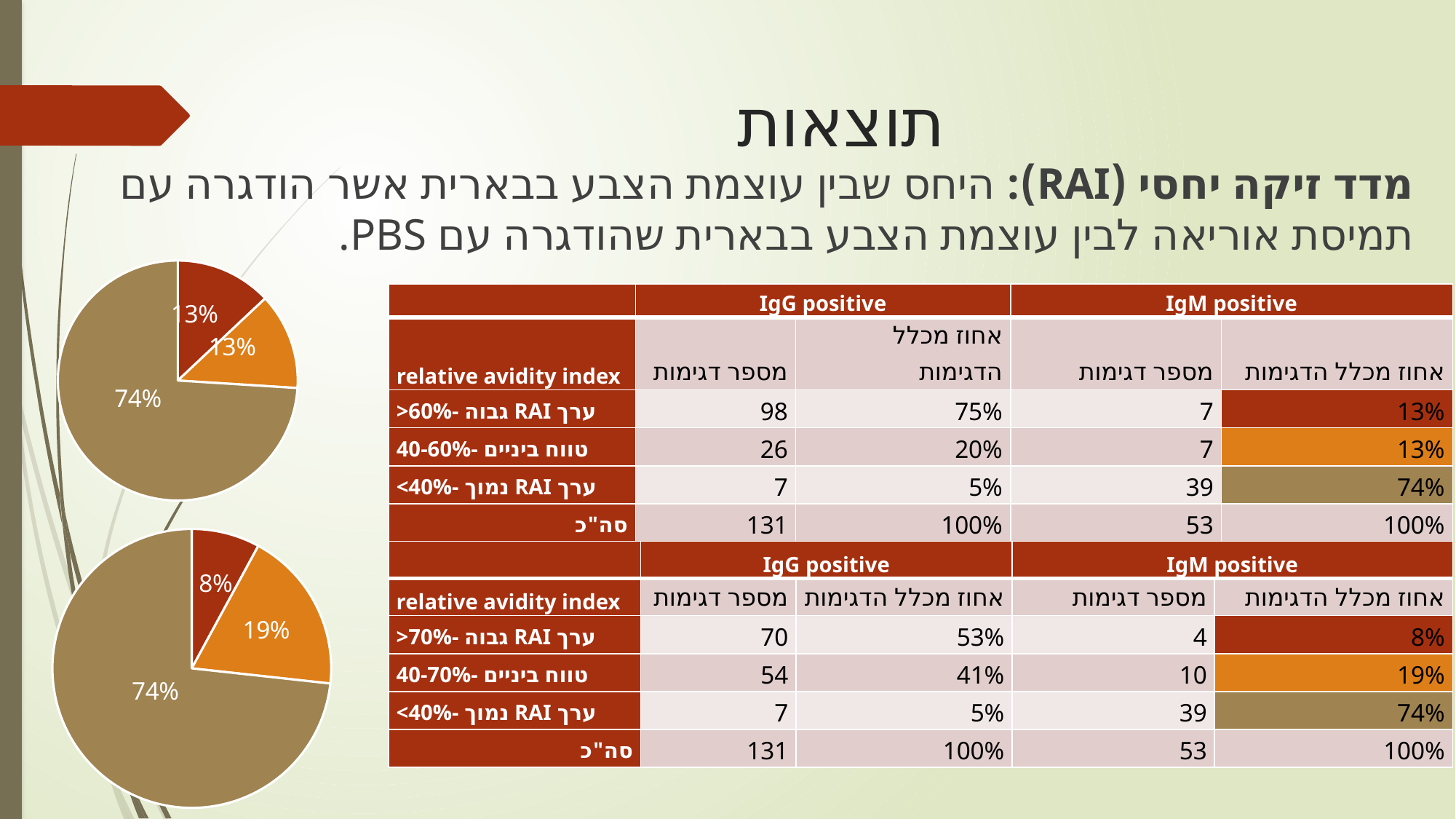
In the bottom pie chart, what is the value of the orange slice? 19% What kind of charts are shown on the left of the slide? Pie charts In the top pie chart, what share does the brown slice represent? 74% In the top pie chart, what is the value of the largest slice? 74% In the bottom pie chart, what do the two smaller slices (8% and 19%) add up to? 27% In the bottom pie chart, what is the value of the dark red slice? 8% In the bottom pie chart, which is larger, the orange slice or the dark red slice? Orange slice What colour is the largest slice in both pie charts? Brown In the top pie chart, which is larger, the dark red slice or the orange slice? They are equal (13% each) In the bottom pie chart, what is the difference between the largest slice and the smallest slice? 66% In the bottom pie chart, what is the value of the smallest slice? 8% In the top pie chart, how many slices are there? 3